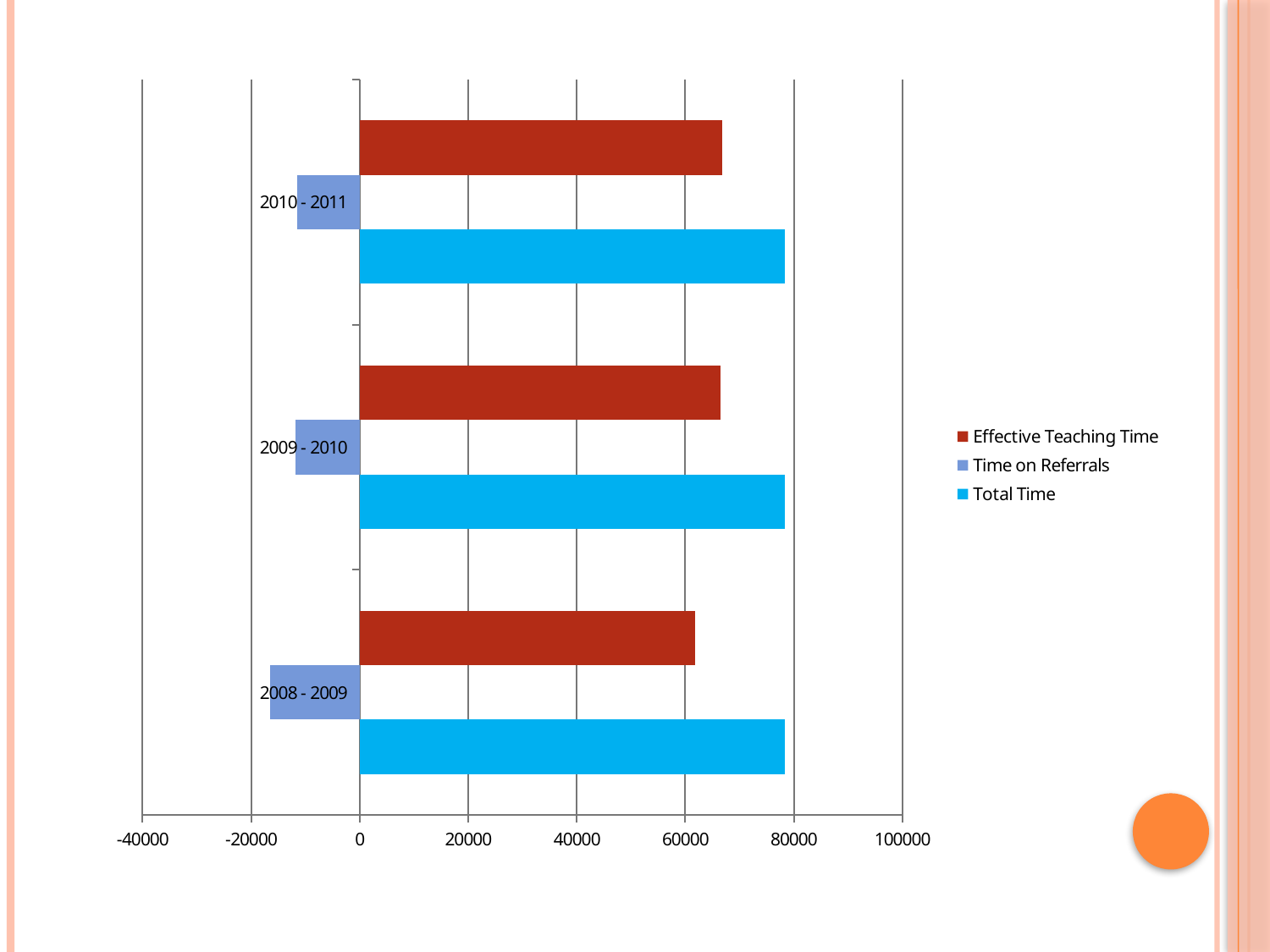
What kind of chart is shown on the slide? Bar chart Is the Time on Referrals for 2008 - 2009 greater or less than 0? less Is Effective Teaching Time larger in 2010 - 2011 or in 2008 - 2009? 2010 - 2011 Which school year has the lowest Effective Teaching Time? 2008 - 2009 Which school year has the longest Time on Referrals bar (the most negative value)? 2008 - 2009 Is the Total Time for 2010 - 2011 greater or less than 60000? greater Does Effective Teaching Time rise or fall from 2008 - 2009 to 2010 - 2011? rise How many school-year categories are shown on the chart? 3 Is the Effective Teaching Time for 2008 - 2009 greater or less than 40000? greater Which series is plotted with negative values (bars extending left of zero)? Time on Referrals How many series does the legend list? 3